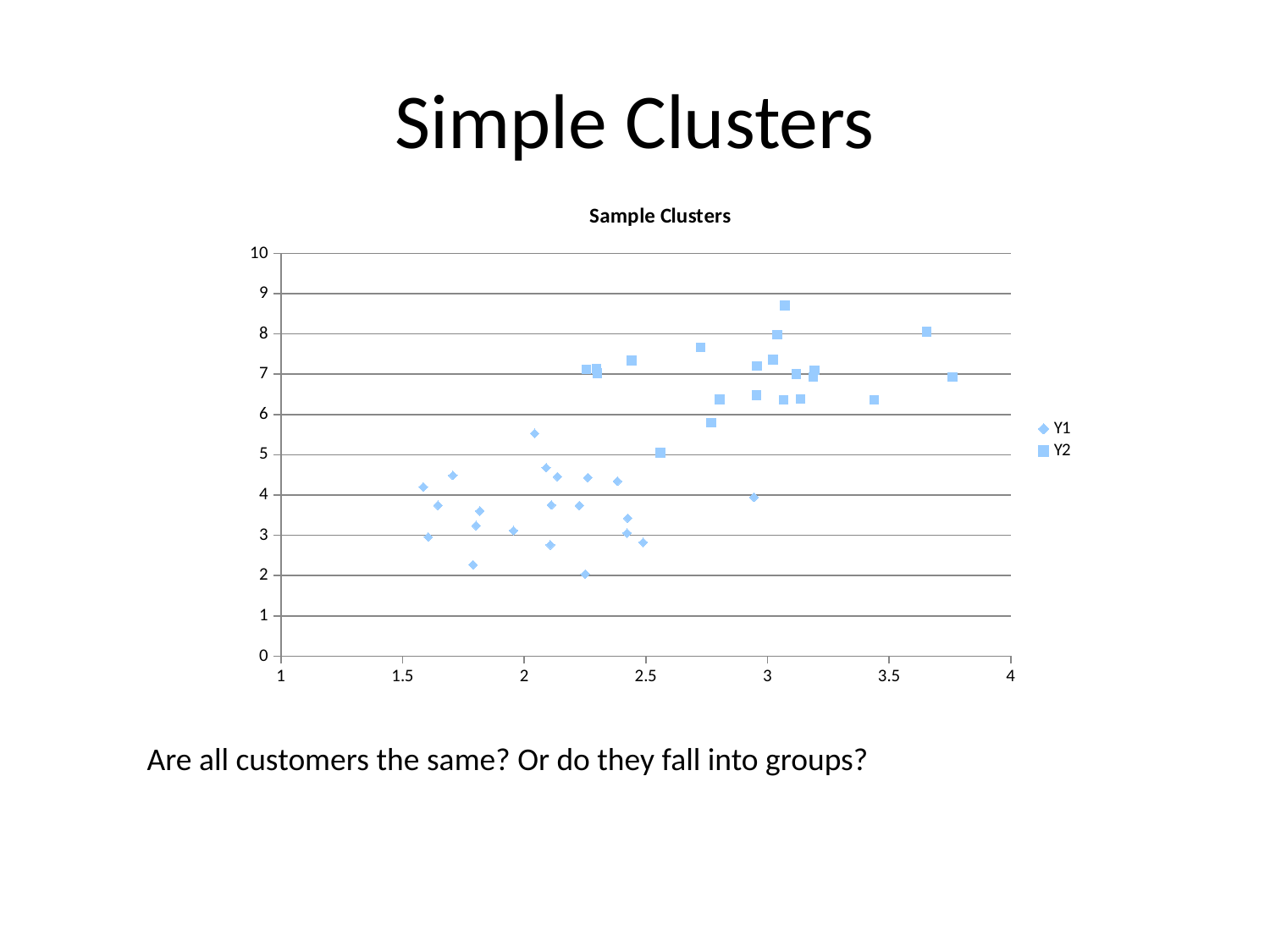
Is the lowest point in series Y1 greater or less than 3? less Are all points in series Y2 greater or less than 4 on the y axis? greater What is the title of the chart? Sample Clusters Do the y-values of the points generally rise or fall as x increases? rise What are the names of the two series in the legend? Y1 and Y2 Are all points in series Y1 greater or less than 6 on the y axis? less Which series contains the lowest point on the chart? Y1 How many series does the legend list? 2 Which series generally has higher y-values, Y1 or Y2? Y2 Which series contains the highest point on the chart? Y2 What kind of chart is shown on the slide? Scatter chart